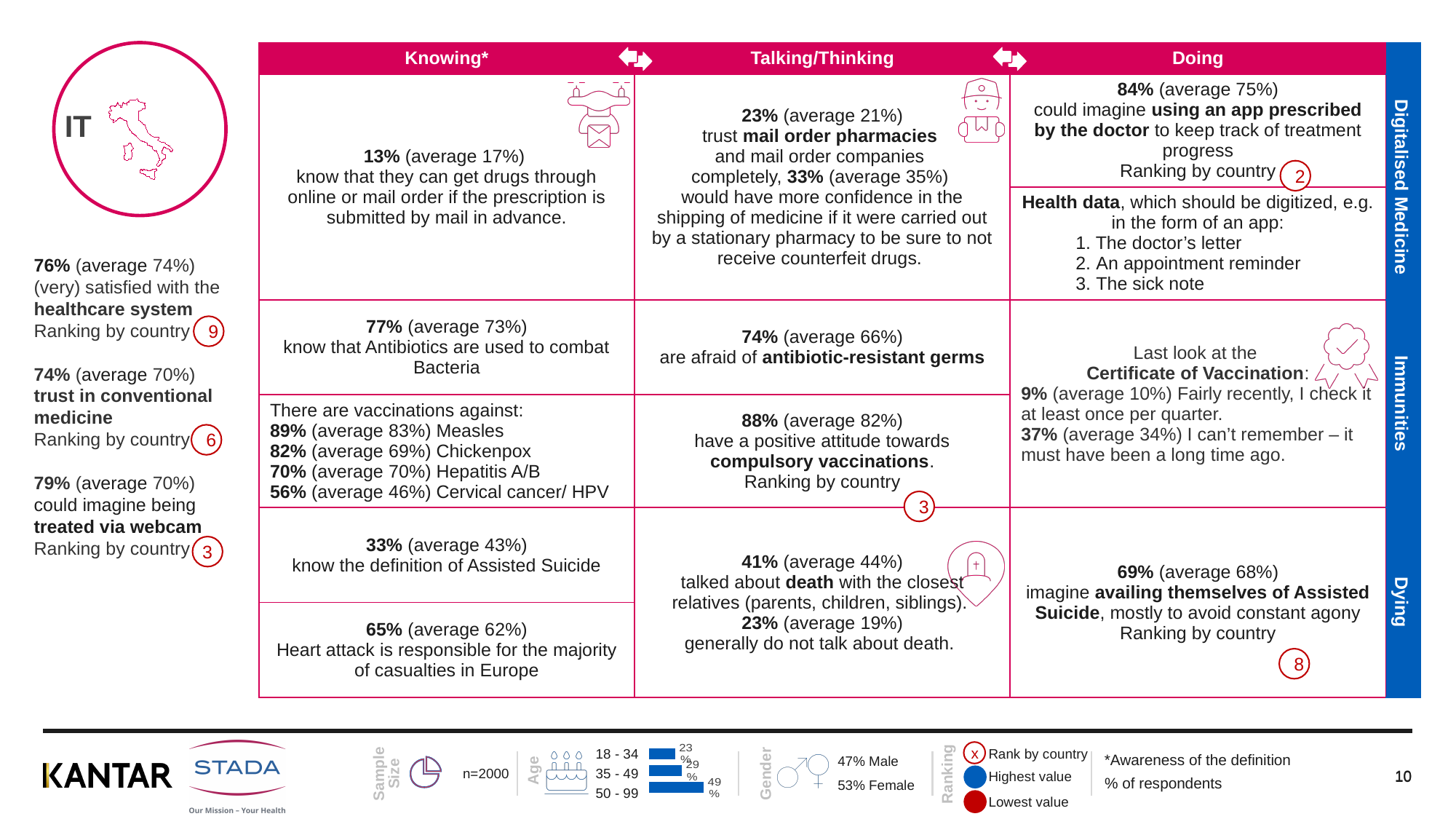
In the Age bar chart at the bottom of the slide, which age group has the highest value? 50 - 99 In the Age bar chart at the bottom of the slide, what is the difference between the 35 - 49 group and the 18 - 34 group? 6% In the Age bar chart at the bottom of the slide, what is the value for the 35 - 49 group? 29% In the Age bar chart at the bottom of the slide, what is the value for the 18 - 34 group? 23% In the Age bar chart at the bottom of the slide, which age group has the lowest value? 18 - 34 What kind of chart is used to show the age distribution at the bottom of the slide? Bar chart What is the total of the three values in the Age bar chart at the bottom of the slide? 101% How many age groups are shown in the Age bar chart at the bottom of the slide? 3 In the Age bar chart at the bottom of the slide, what is the difference between the 50 - 99 group and the 18 - 34 group? 26% In the Age bar chart at the bottom of the slide, which is larger: the value for 35 - 49 or the value for 50 - 99? 50 - 99 In the Age bar chart at the bottom of the slide, what is the value for the 50 - 99 group? 49% In the Age bar chart at the bottom of the slide, do the values rise or fall as the age groups get older? Rise